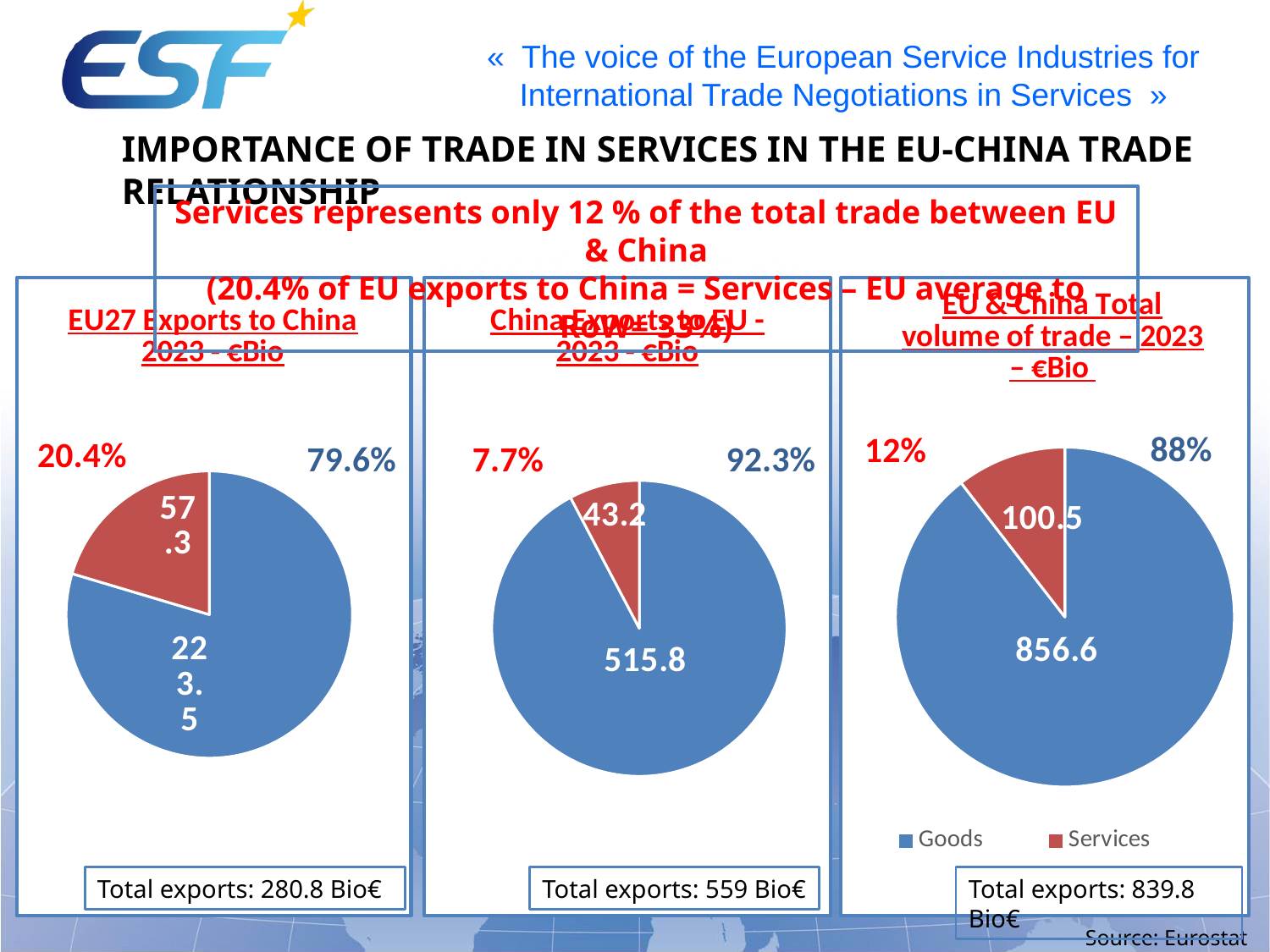
In the left chart (EU27 Exports to China 2023 - €Bio), what is the value for Goods? 223.5 How many series does the legend list? 2 In the right chart (EU & China Total volume of trade – 2023 – €Bio), what is the difference between the Goods value and the Services value? 756.1 What type of chart is used on this slide? Pie chart In the middle chart (China Exports to EU), what is the value for Services? 43.2 In the right chart (EU & China Total volume of trade – 2023 – €Bio), what share of the pie does Goods represent? 88% In the left chart (EU27 Exports to China 2023 - €Bio), what is the value for Services? 57.3 In the middle chart (China Exports to EU), what is the value for Goods? 515.8 In the left chart (EU27 Exports to China 2023 - €Bio), which slice is the largest? Goods In the right chart (EU & China Total volume of trade – 2023 – €Bio), what is the value for Services? 100.5 In the left chart (EU27 Exports to China 2023 - €Bio), what share of the pie does Services represent? 20.4% In the middle chart (China Exports to EU), what share of the pie does Services represent? 7.7%